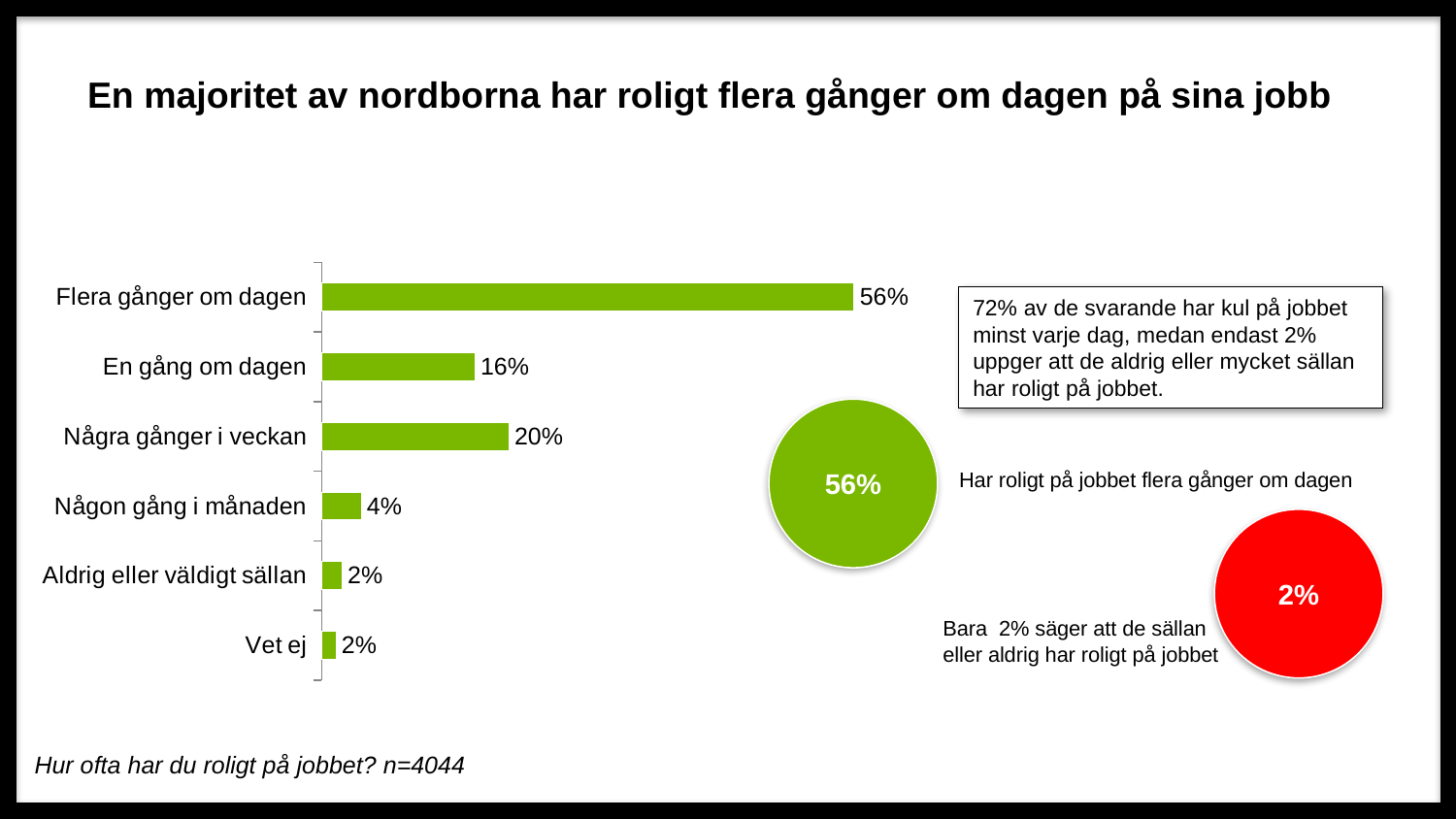
What colour are the bars in the chart? Green What is the value for "Några gånger i veckan"? 20% What is the difference between "Några gånger i veckan" and "En gång om dagen"? 4 percentage points Which is larger, "En gång om dagen" or "Några gånger i veckan"? Några gånger i veckan What is the difference between "Flera gånger om dagen" and "Några gånger i veckan"? 36 percentage points What kind of chart is shown on the slide? Bar chart What is the value for "Vet ej"? 2% What is the value for "En gång om dagen"? 16% What is the value for "Någon gång i månaden"? 4% How many categories are shown in the bar chart? 6 Which category has the highest value? Flera gånger om dagen What is the value for "Flera gånger om dagen"? 56%